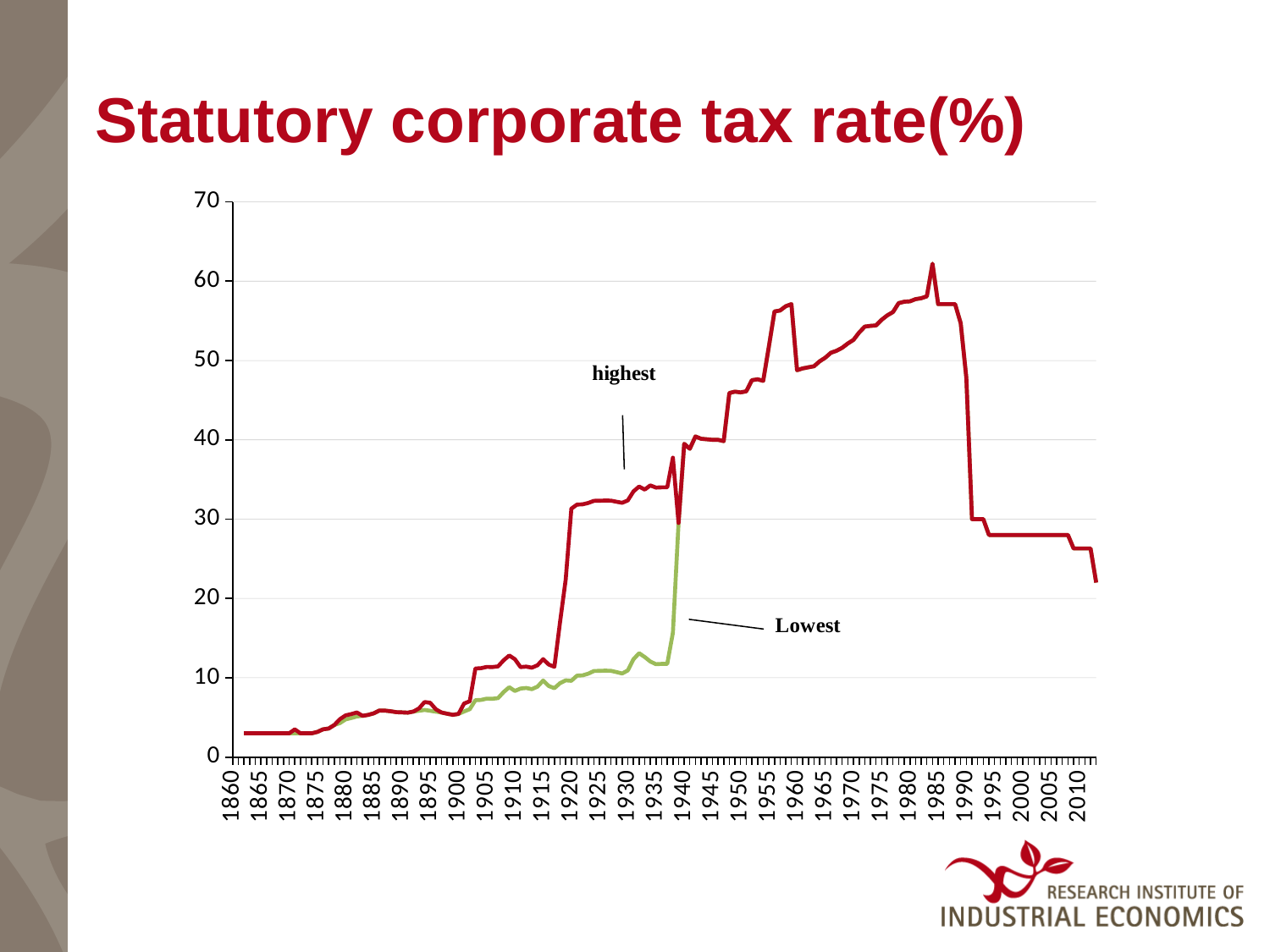
Is the value of the "highest" series in 1975 greater or less than 50? greater What is the title of the chart on the slide? Statutory corporate tax rate(%) Is the value of the "highest" series in 1995 greater or less than 30? less Is the value of the "Lowest" series in 1900 greater or less than 10? less How many series are plotted on the chart? 2 Does the "highest" series rise or fall between 1990 and 2010? fall What kind of chart is shown on the slide? line chart In 1930, which series has the larger value, "highest" or "Lowest"? highest What colour is the line labelled "Lowest"? green